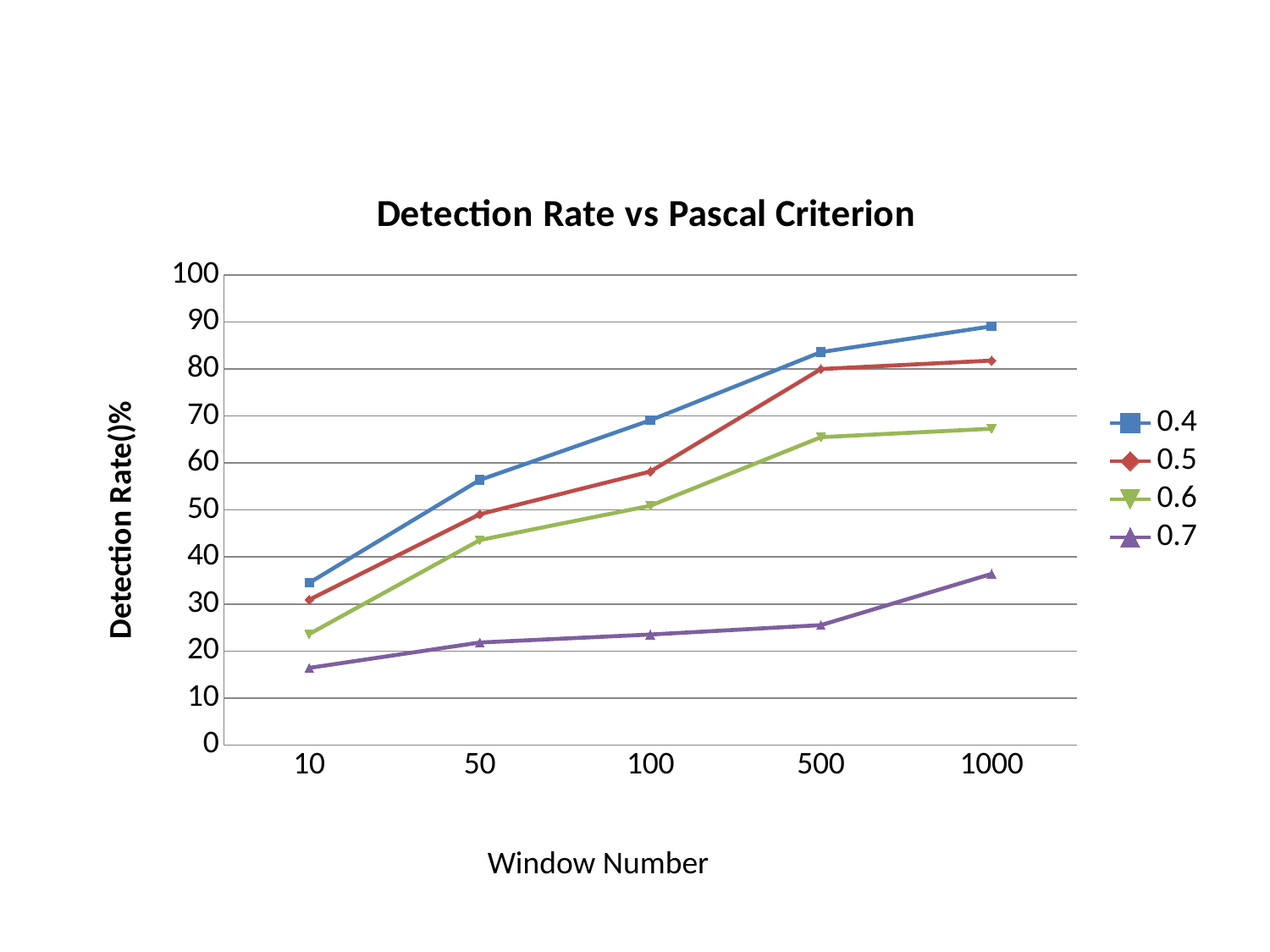
Is the detection rate for series 0.7 at window number 10 greater or less than 20? less Is the detection rate for series 0.6 at window number 500 greater or less than 60? greater What is the title of the chart? Detection Rate vs Pascal Criterion Is the detection rate for series 0.4 at window number 1000 greater or less than 80? greater Which series has the lowest detection rate at window number 10? 0.7 At window number 100, which series has the larger detection rate, 0.5 or 0.6? 0.5 How many series does the legend list? 4 How many window number categories are shown on the x axis? 5 Does the detection rate for series 0.4 rise or fall as the window number increases? rise What type of chart is shown on the slide? line chart Which series has the highest detection rate at window number 1000? 0.4